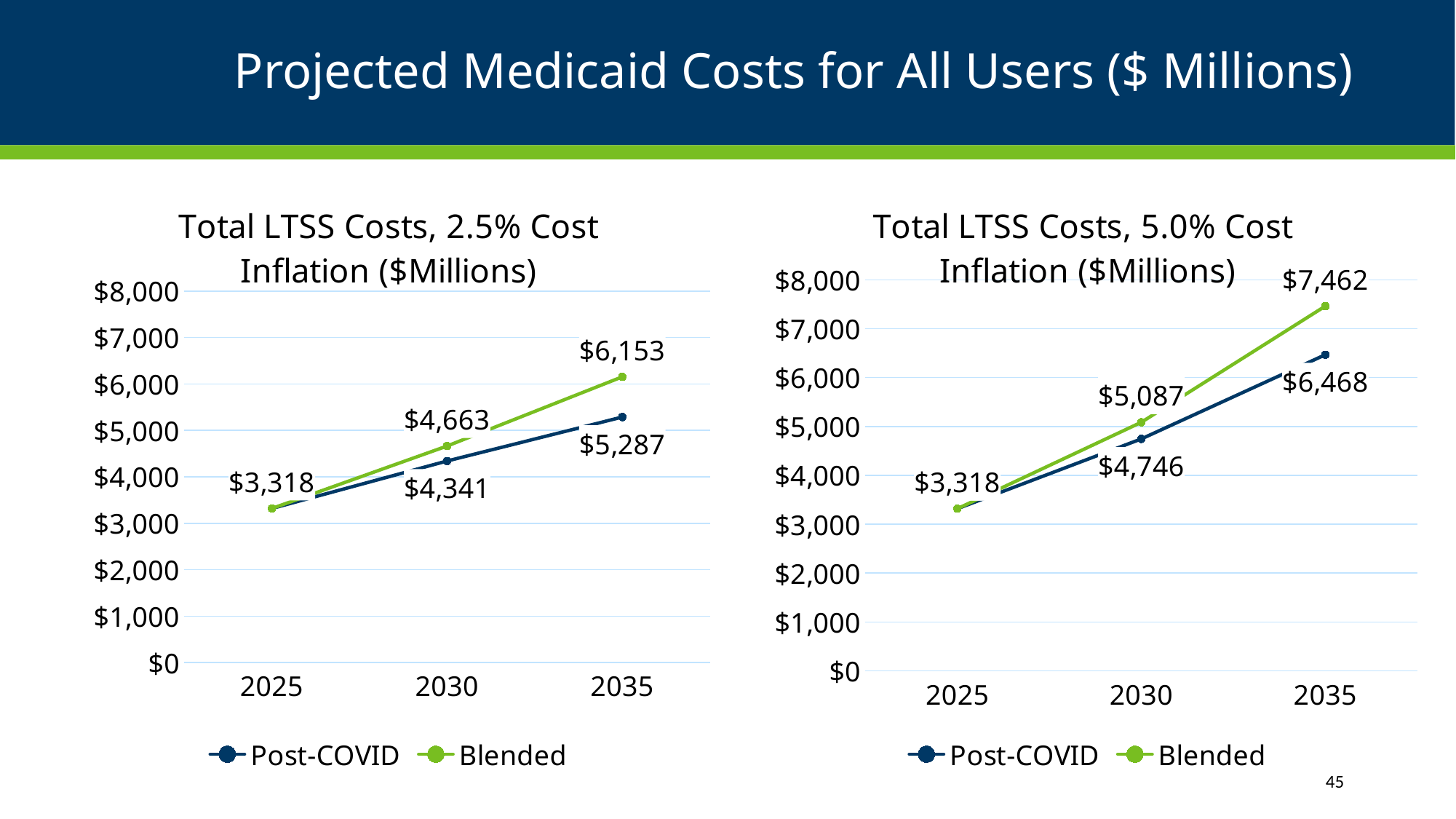
In the 5.0% Cost Inflation chart, what is the difference between the Blended and Post-COVID values in 2035? $994 How many years are shown on the x axis of the 5.0% Cost Inflation chart? 3 What kind of chart is the 5.0% Cost Inflation chart? Line chart In the 2.5% Cost Inflation chart, what is the Blended value for 2035? $6,153 In the 5.0% Cost Inflation chart, what is the Post-COVID value for 2030? $4,746 In the 5.0% Cost Inflation chart, which series has the higher value in 2030, Post-COVID or Blended? Blended In the 2.5% Cost Inflation chart, do the Blended values rise or fall from 2025 to 2035? Rise In the 5.0% Cost Inflation chart, what is the Blended value for 2035? $7,462 In the 2.5% Cost Inflation chart, what is the difference between the Blended and Post-COVID values in 2035? $866 In the 2.5% Cost Inflation chart, what is the Post-COVID value for 2030? $4,341 In the 2.5% Cost Inflation chart, is the Post-COVID value for 2035 greater or less than $5,000? greater How many series does the legend of the 2.5% Cost Inflation chart list? 2